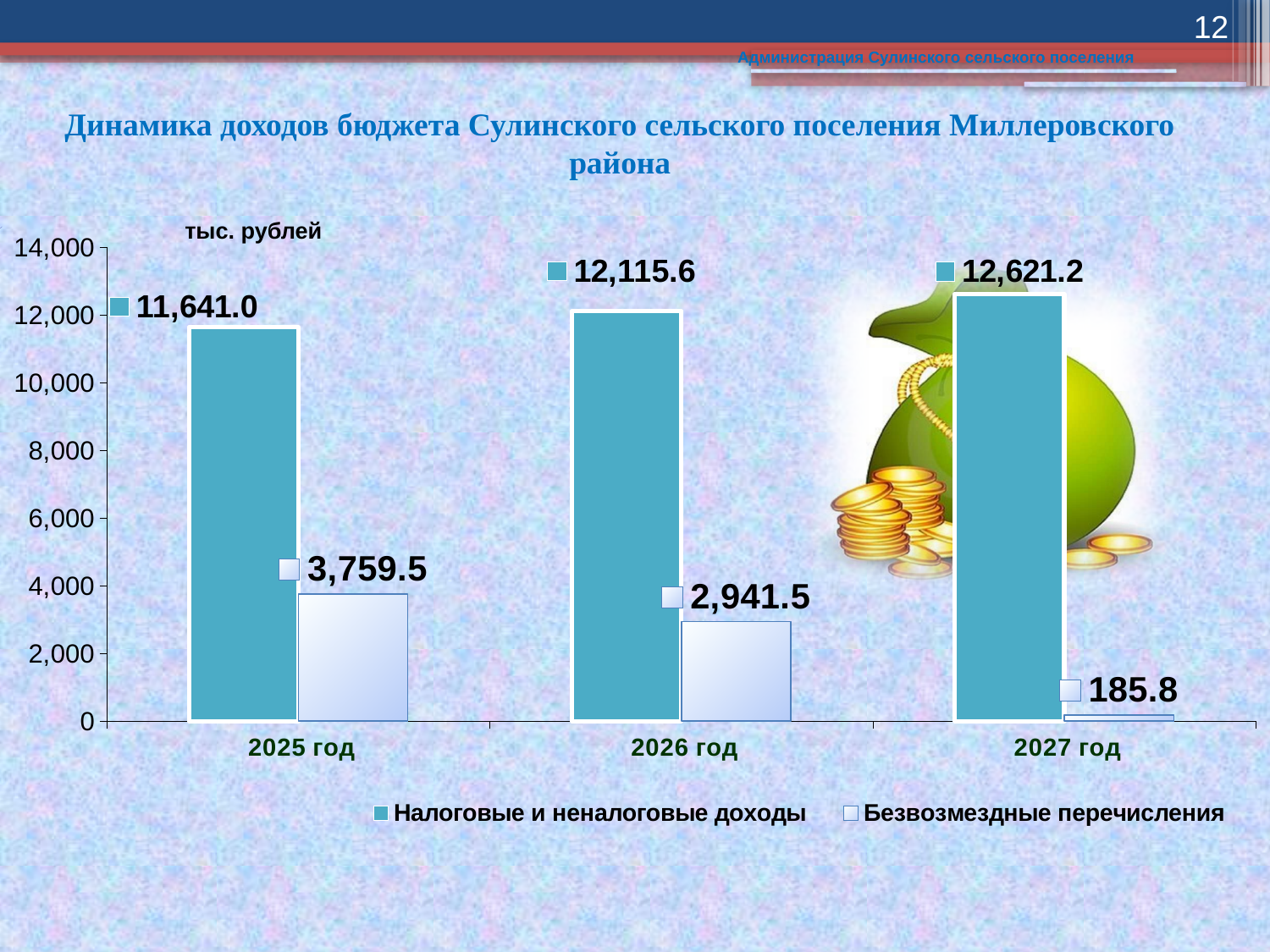
In which year is Безвозмездные перечисления lowest? 2027 год Which is larger: Безвозмездные перечисления in 2025 год or in 2026 год? 2025 год How many years are shown on the x axis? 3 What is the value of Безвозмездные перечисления for 2027 год? 185.8 Do the values of Безвозмездные перечисления rise or fall from 2025 год to 2027 год? fall What is the difference between Налоговые и неналоговые доходы in 2027 год and in 2025 год? 980.2 What is the value of Налоговые и неналоговые доходы for 2025 год? 11,641.0 What is the difference between Безвозмездные перечисления in 2025 год and in 2026 год? 818.0 What kind of chart is shown on the slide? bar chart In which year is Налоговые и неналоговые доходы highest? 2027 год What is the value of Безвозмездные перечисления for 2026 год? 2,941.5 How many series does the legend list? 2